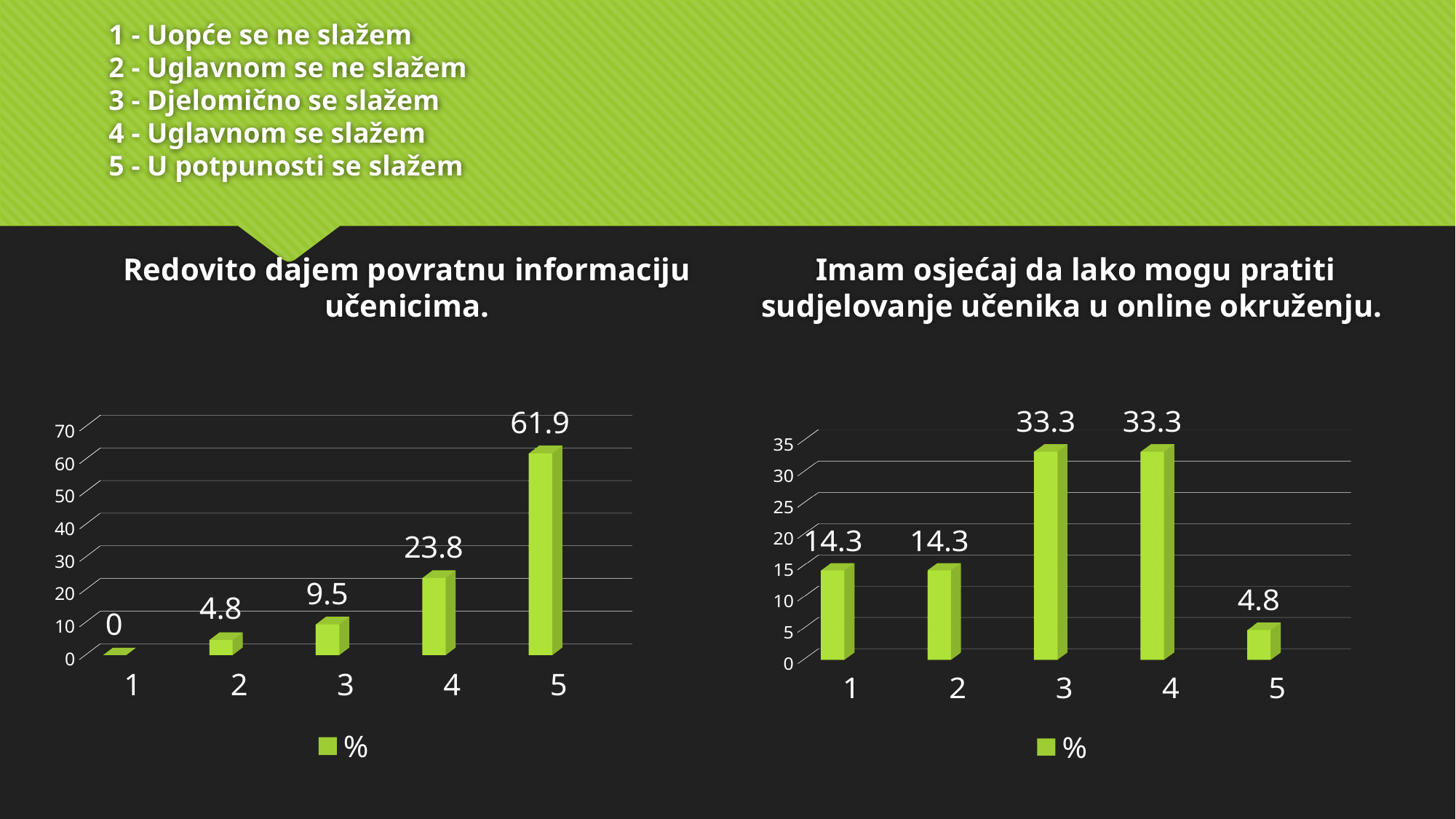
In the left chart 'Redovito dajem povratnu informaciju učenicima.', what is the value for category 5? 61.9 In the right chart 'Imam osjećaj da lako mogu pratiti sudjelovanje učenika u online okruženju.', what is the value for category 5? 4.8 In the left chart 'Redovito dajem povratnu informaciju učenicima.', which category has the lowest value? 1 In the left chart 'Redovito dajem povratnu informaciju učenicima.', do the values rise or fall from category 1 to category 5? rise In the left chart 'Redovito dajem povratnu informaciju učenicima.', what is the difference between the values for category 5 and category 4? 38.1 What kind of chart is the right chart 'Imam osjećaj da lako mogu pratiti sudjelovanje učenika u online okruženju.'? bar chart In the right chart 'Imam osjećaj da lako mogu pratiti sudjelovanje učenika u online okruženju.', which category has the lowest value? 5 How many categories are shown on the x axis of the left chart 'Redovito dajem povratnu informaciju učenicima.'? 5 In the right chart 'Imam osjećaj da lako mogu pratiti sudjelovanje učenika u online okruženju.', what is the difference between the values for category 3 and category 1? 19 In the left chart 'Redovito dajem povratnu informaciju učenicima.', what is the value for category 4? 23.8 In the right chart 'Imam osjećaj da lako mogu pratiti sudjelovanje učenika u online okruženju.', what is the value for category 3? 33.3 In the right chart 'Imam osjećaj da lako mogu pratiti sudjelovanje učenika u online okruženju.', is the value for category 1 larger or smaller than the value for category 5? larger